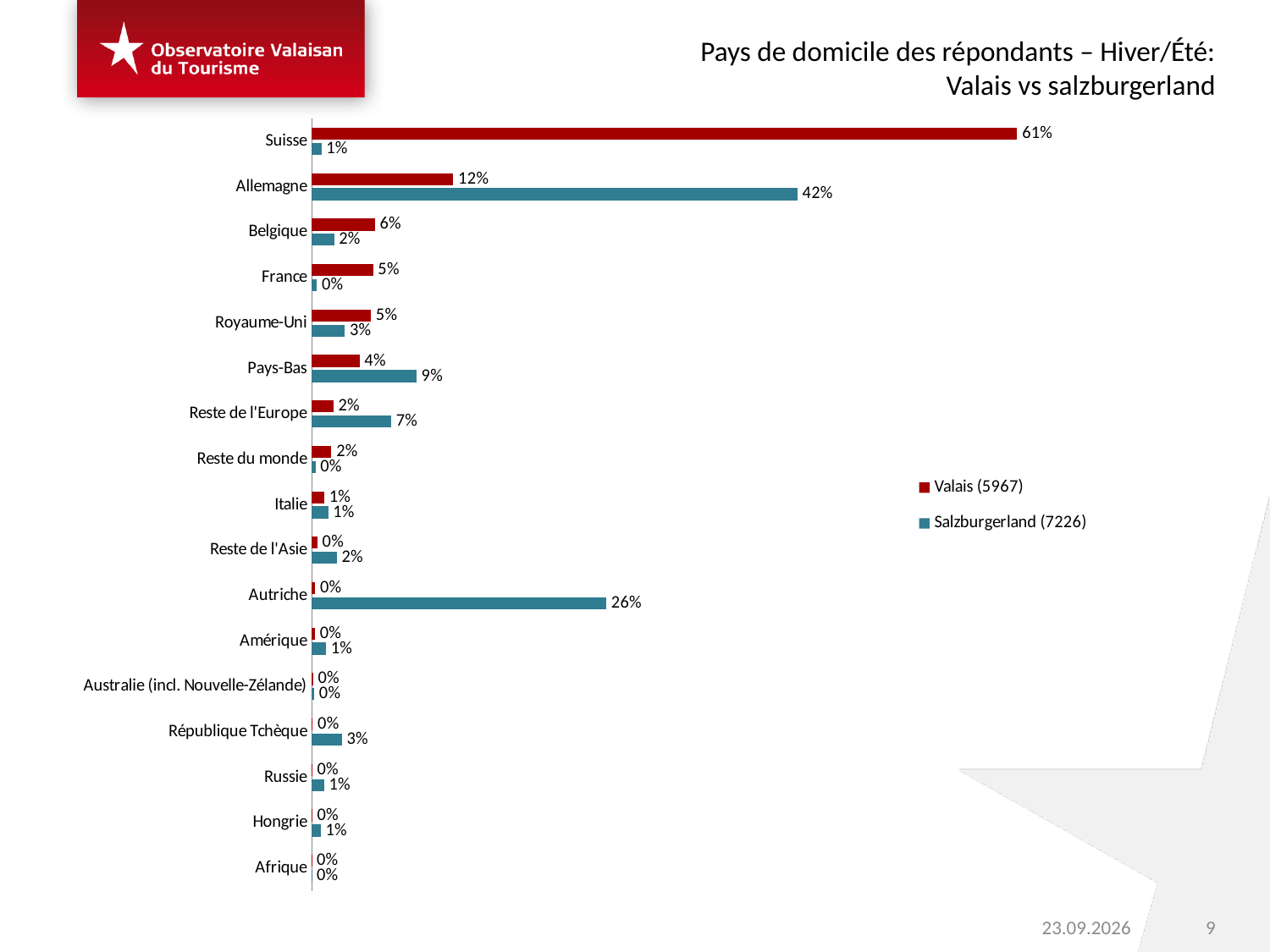
What kind of chart is shown on the slide? Bar chart Which country has the highest value in the Valais (5967) series? Suisse What is the value for Suisse in the Valais (5967) series? 61% How many countries or regions are shown on the chart? 17 What is the value for Autriche in the Salzburgerland (7226) series? 26% What is the difference between the Valais and Salzburgerland values for Allemagne? 30% How many series does the legend list? 2 What is the value for Pays-Bas in the Valais (5967) series? 4% Which country has the highest value in the Salzburgerland (7226) series? Allemagne What is the value for Allemagne in the Salzburgerland (7226) series? 42% What colour represents the Valais (5967) series? Dark red For Pays-Bas, which series has the larger value, Valais (5967) or Salzburgerland (7226)? Salzburgerland (7226)